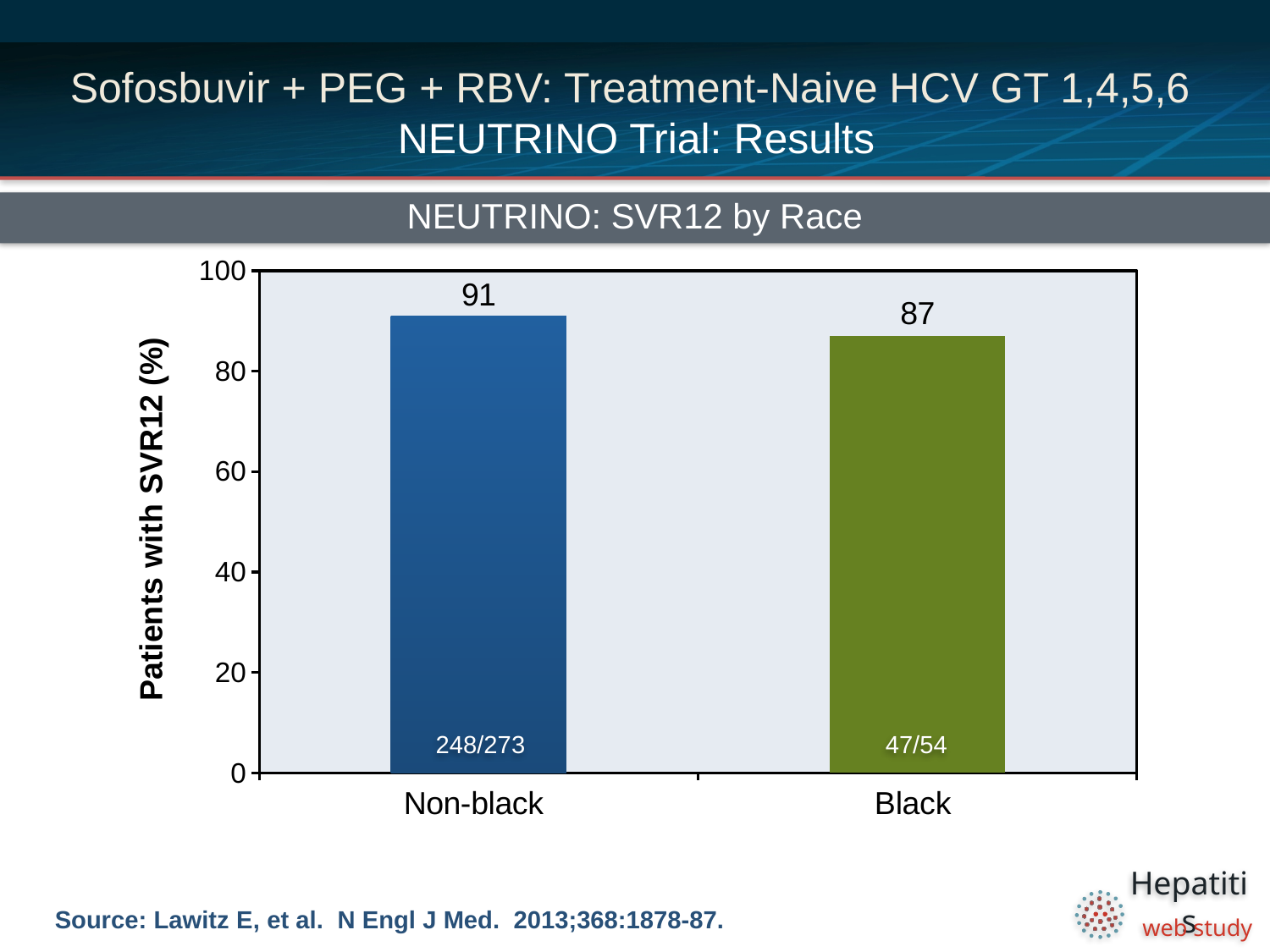
What is the difference in SVR12 rate between Non-black and Black patients? 4 What fraction of patients is printed inside the Non-black bar? 248/273 Which race group has the lower SVR12 rate? Black What fraction of patients is printed inside the Black bar? 47/54 What is the title of the chart? NEUTRINO: SVR12 by Race What is the label of the y-axis? Patients with SVR12 (%) What kind of chart is shown on the slide? bar chart What is the SVR12 rate for Black patients? 87 What is the SVR12 rate for Non-black patients? 91 Is the SVR12 rate for Black patients greater or less than 80? greater Which race group has the higher SVR12 rate? Non-black How many race categories are shown in the chart? 2